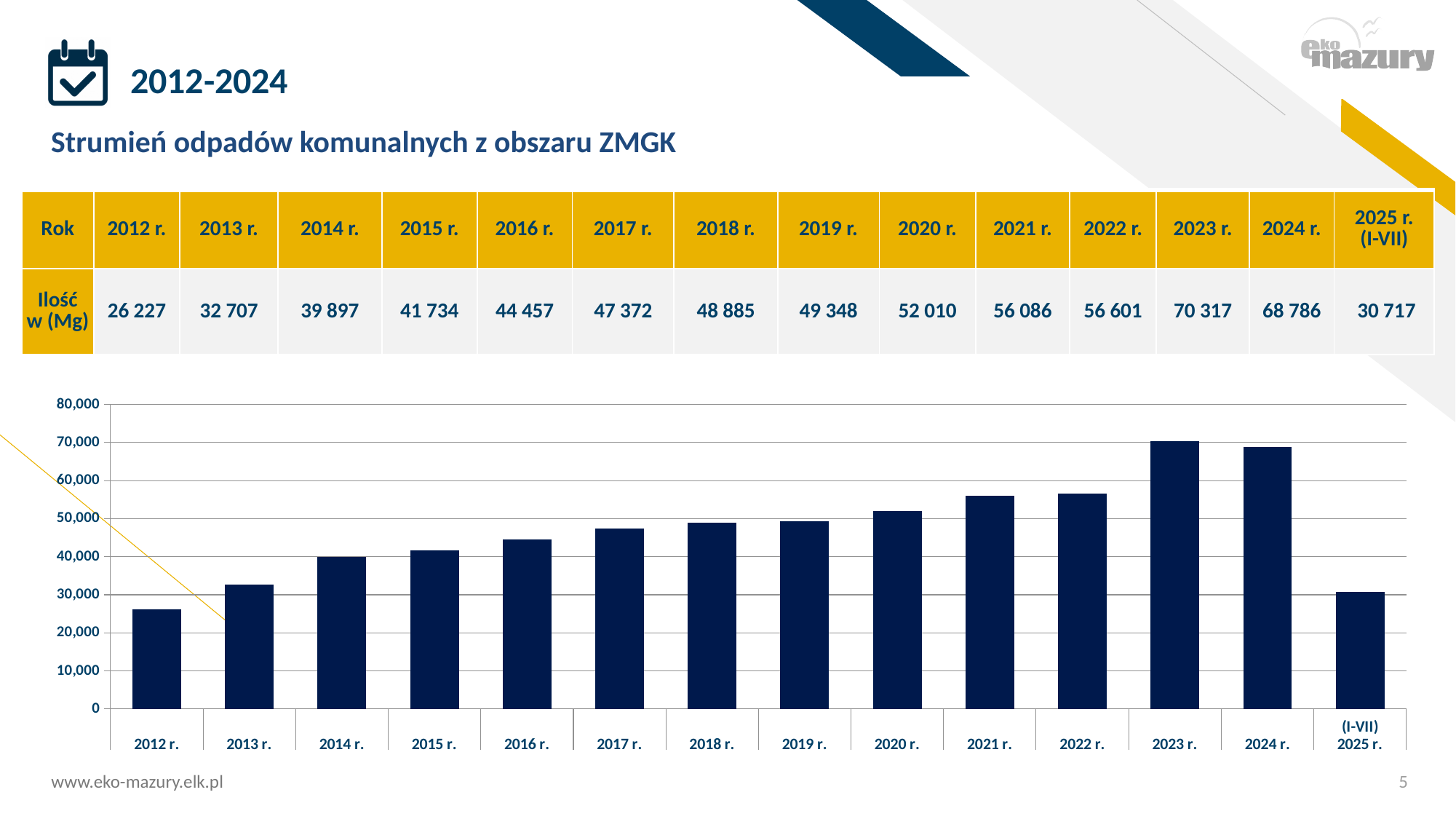
How many bars (years) does the chart show? 14 Which year has the lowest value in the chart? 2012 r. Do the values rise or fall from 2012 r. to 2023 r.? rise What kind of chart is shown on the slide? bar chart What is the difference between the values for 2023 r. and 2024 r.? 1 531 Which is larger, the value for 2020 r. or the value for 2019 r.? 2020 r. Which year has the highest value in the chart? 2023 r. What is the value (Ilość w Mg) for 2018 r.? 48 885 Is the value for 2016 r. greater or less than 40,000? greater What is the difference between the values for 2013 r. and 2012 r.? 6 480 What is the value (Ilość w Mg) for 2025 r. (I-VII)? 30 717 What is the value (Ilość w Mg) for 2023 r.? 70 317